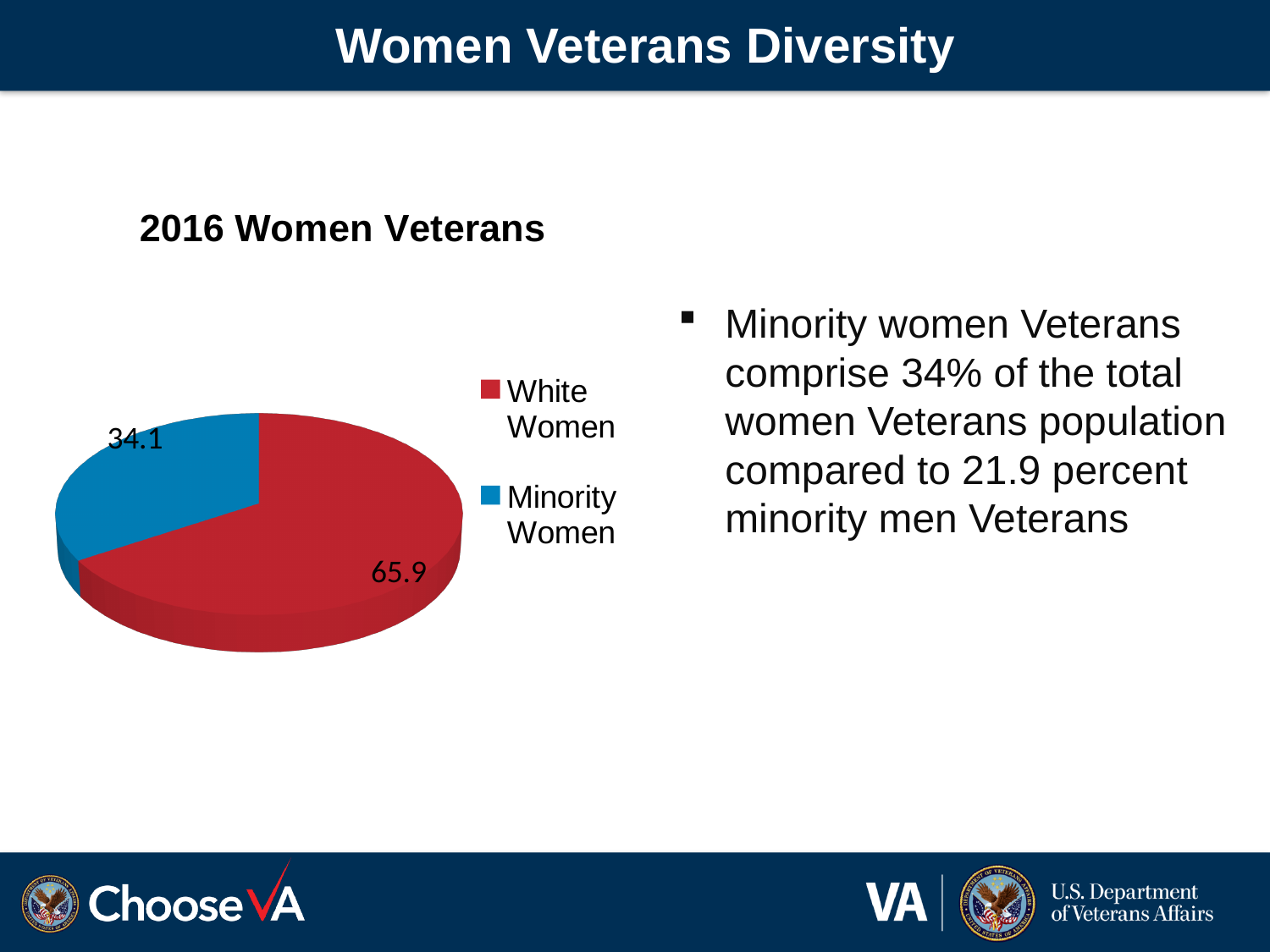
What is the title of the chart? 2016 Women Veterans Which category has the smallest slice of the pie chart? Minority Women What colour is the slice for Minority Women? Blue What is the value shown for White Women in the pie chart? 65.9 What is the total of the two values shown in the pie chart? 100 What kind of chart is shown on the slide? Pie chart Which category has the largest slice of the pie chart? White Women Which is larger, the value for White Women or the value for Minority Women? White Women How many categories does the pie chart show? 2 What is the value shown for Minority Women in the pie chart? 34.1 What is the difference between the values for White Women and Minority Women? 31.8